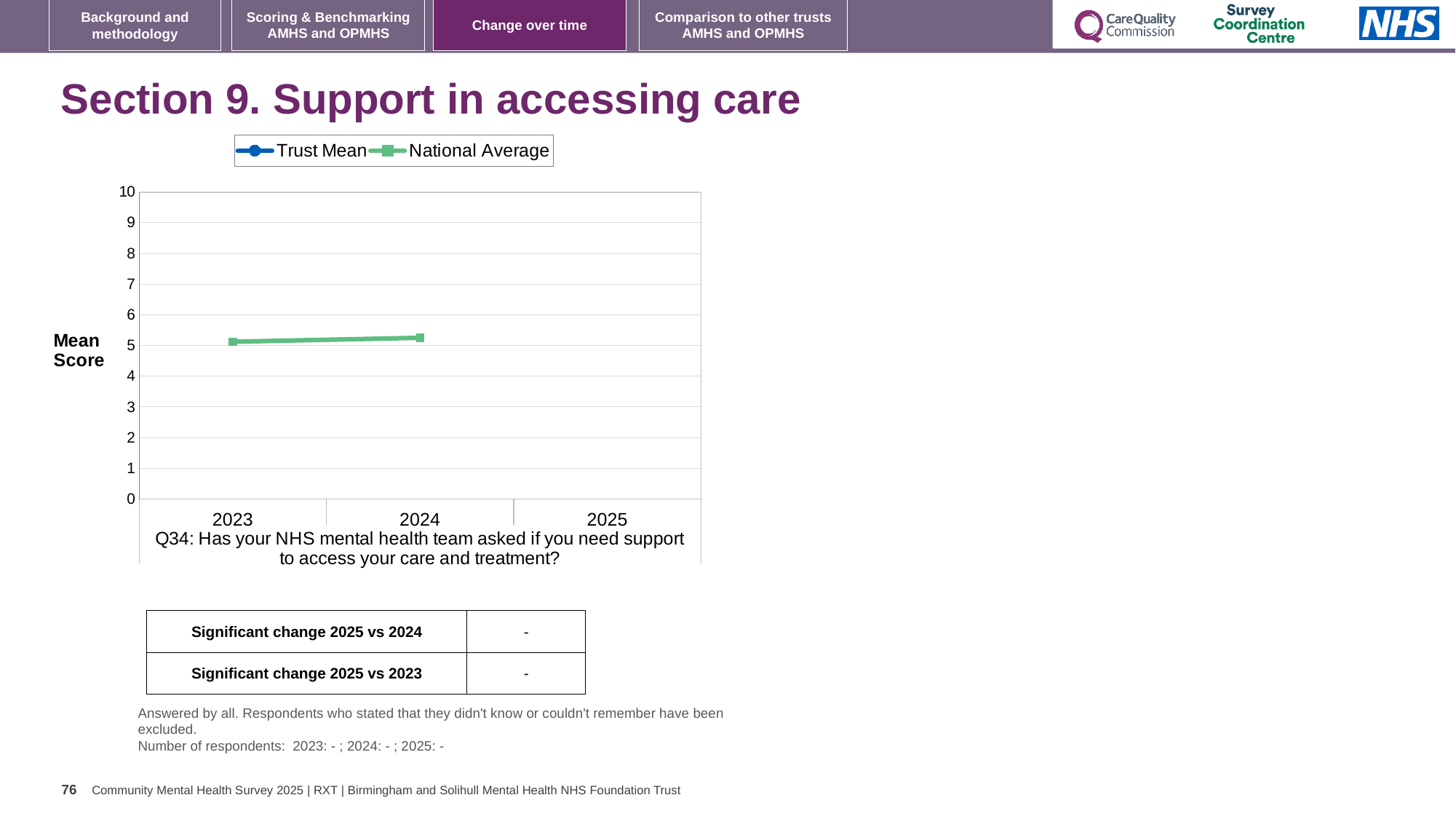
Does the National Average line rise or fall from 2023 to 2024? rise Is the National Average value for 2024 greater or less than 7? less Is the National Average value for 2023 greater or less than 6? less Is the National Average value for 2024 greater or less than 4? greater What kind of chart is shown on the slide? line chart How many series does the chart legend list? 2 Which two series are listed in the chart legend? Trust Mean and National Average How many years are shown on the x axis of the chart? 3 What is the highest value shown on the y axis of the chart? 10 What is the label on the y axis of the chart? Mean Score